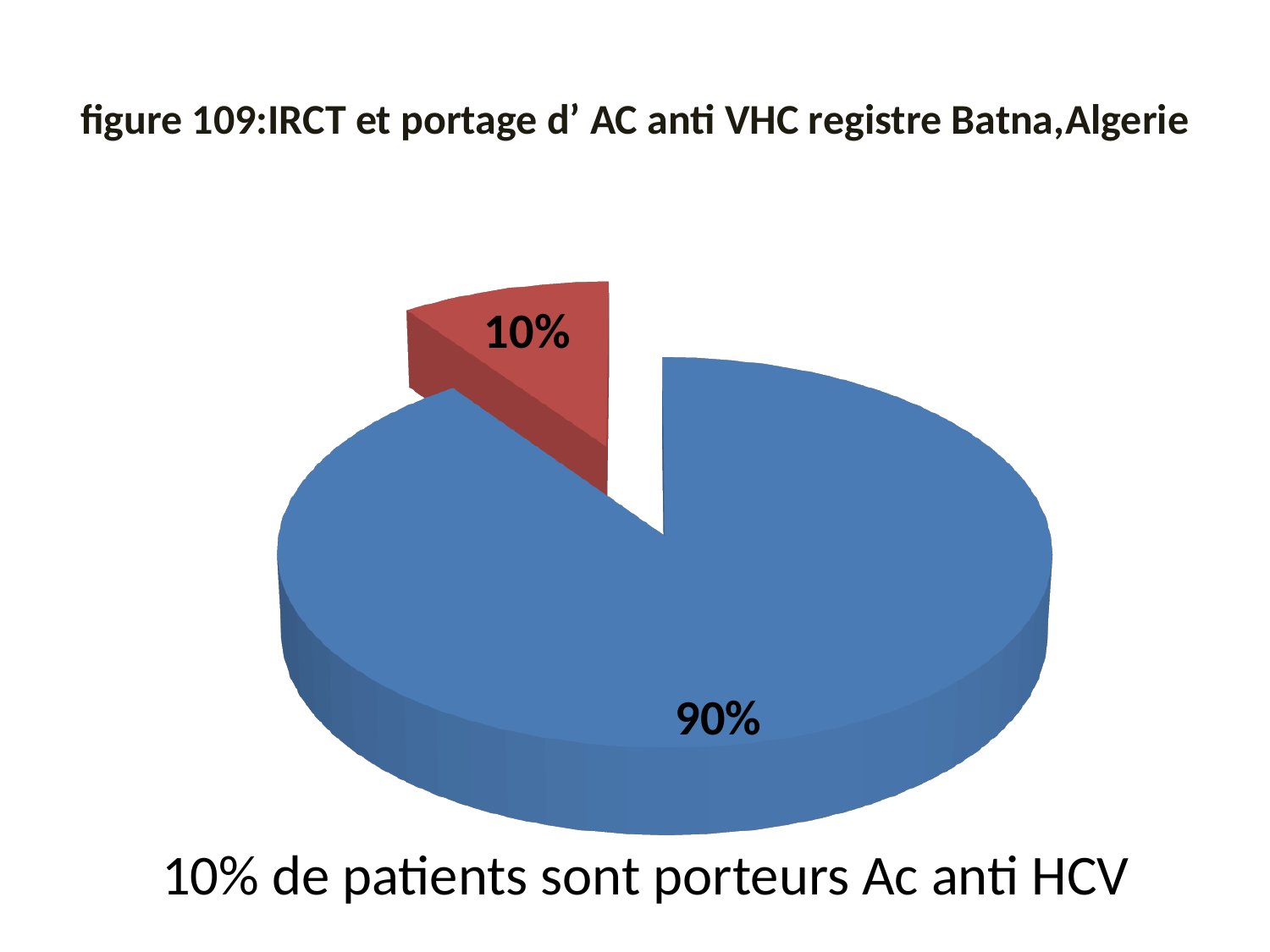
What percentage is shown on the blue slice of the pie chart? 90% Which slice of the pie chart is pulled out (exploded) from the rest? the red 10% slice What is the value of the smallest slice in the pie chart? 10% Which slice is larger, the red one or the blue one? the blue one How many slices does the pie chart have? 2 What kind of chart is shown on the slide? pie chart What is the figure number given in the chart title? figure 109 What is the value of the largest slice in the pie chart? 90% According to the slide, what share of patients carry anti-HCV antibodies (Ac anti HCV)? 10% What is the difference between the two slices of the pie chart? 80% What percentage is shown on the red slice of the pie chart? 10%